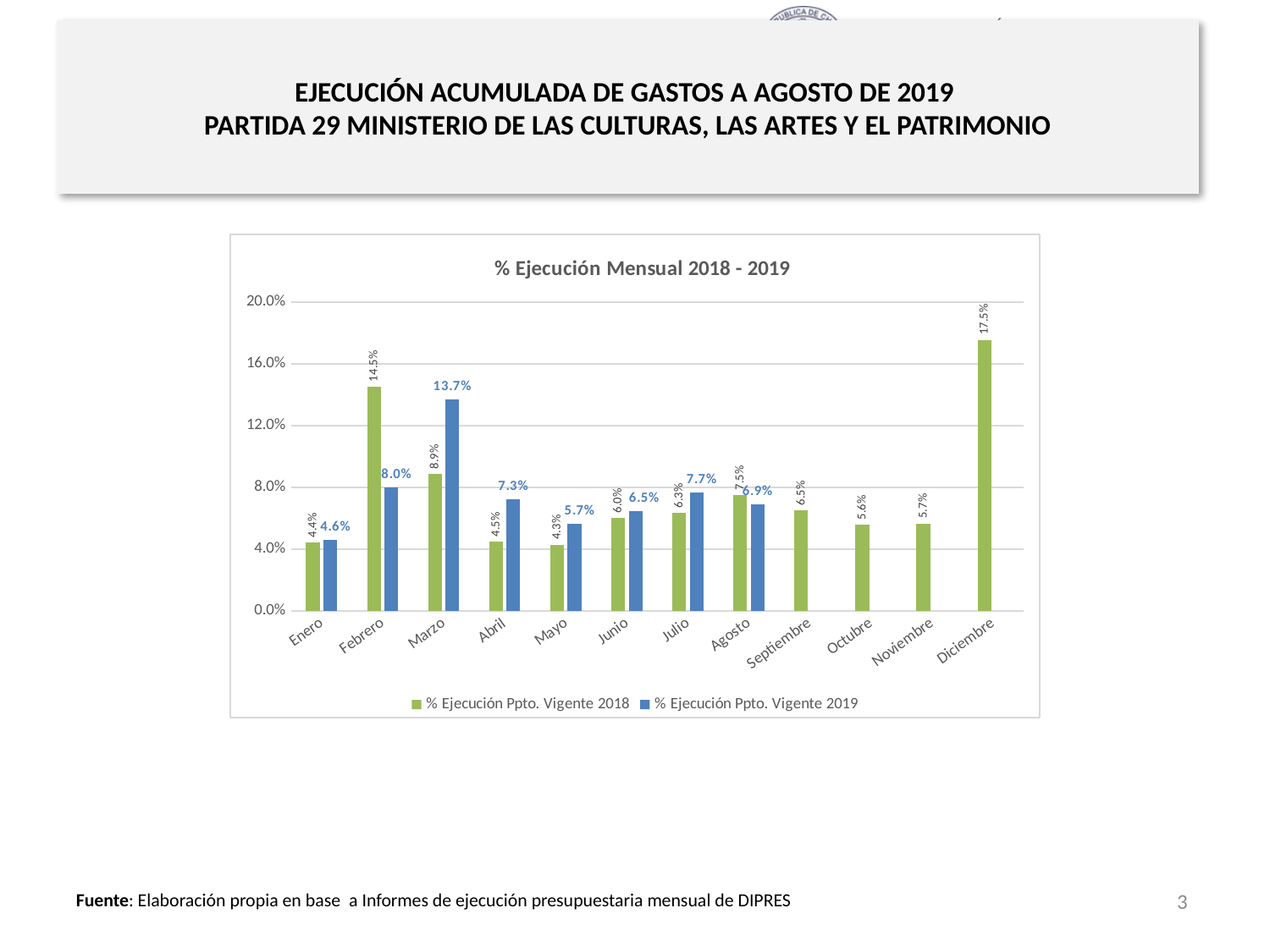
Which month has the lowest value for % Ejecución Ppto. Vigente 2019? Enero What is the difference between the 2018 and 2019 values for Febrero? 6.5% How many series does the legend list? 2 What type of chart is shown on the slide? bar chart Is the value of % Ejecución Ppto. Vigente 2018 for Diciembre greater or less than 16.0%? greater What is the value of % Ejecución Ppto. Vigente 2019 for Marzo? 13.7% What is the value of % Ejecución Ppto. Vigente 2018 for Febrero? 14.5% How many months are shown on the x axis? 12 For Agosto, which series has the larger value, 2018 or 2019? % Ejecución Ppto. Vigente 2018 What is the title of the chart? % Ejecución Mensual 2018 - 2019 Which month has the highest value for % Ejecución Ppto. Vigente 2018? Diciembre What is the value of % Ejecución Ppto. Vigente 2018 for Octubre? 5.6%